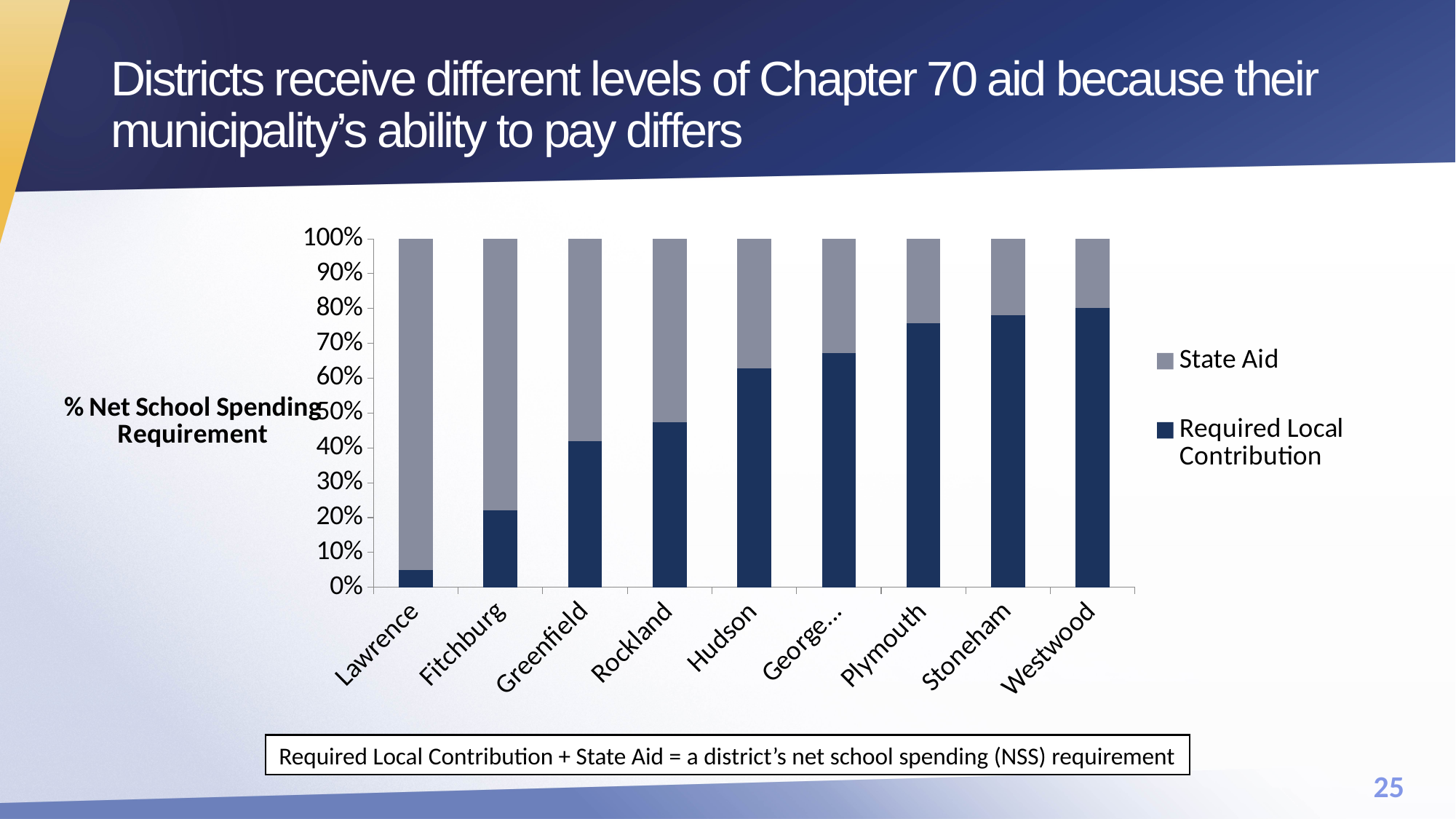
How many series does the chart's legend list? 2 What kind of chart is shown on the slide? Stacked bar chart Which district has the larger Required Local Contribution share, Greenfield or Plymouth? Plymouth What is the total of each stacked bar in the chart? 100% Which district has the lowest Required Local Contribution share? Lawrence Which district has the highest State Aid share? Lawrence Is the Required Local Contribution for Fitchburg greater or less than 20%? greater Is the Required Local Contribution for Hudson greater or less than 60%? greater Is the Required Local Contribution for Lawrence greater or less than 10%? less Does the Required Local Contribution share rise or fall moving from Lawrence to Westwood along the x axis? Rise How many districts are shown on the x axis of the chart? 9